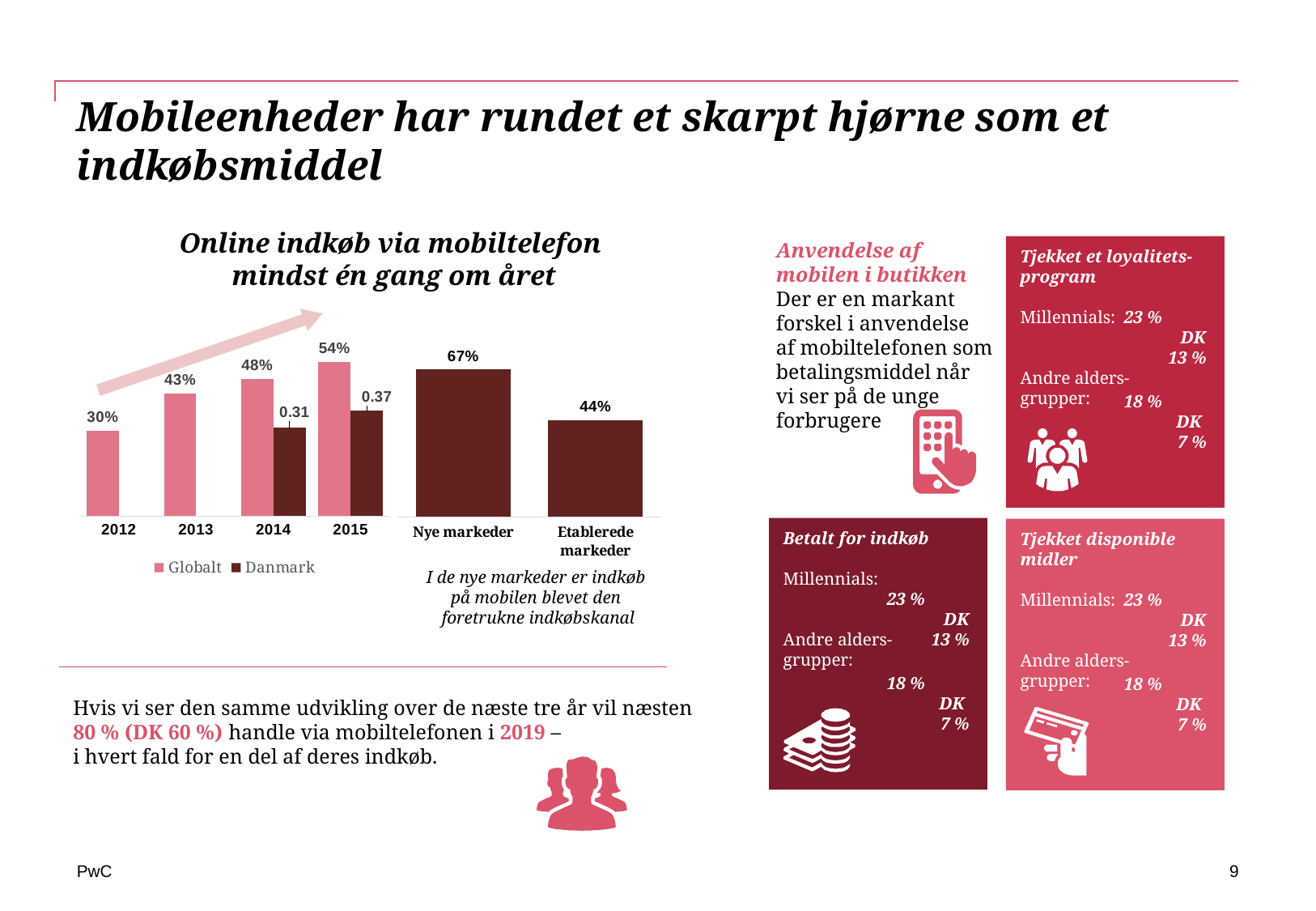
What is the Globalt value for 2012 in the chart 'Online indkøb via mobiltelefon mindst én gang om året'? 30% What is the difference between the Globalt values for 2015 and 2012? 24% Does the Globalt series rise or fall from 2012 to 2015? rise What value is shown for 'Nye markeder' in the chart? 67% Which is larger, the value for 'Nye markeder' or 'Etablerede markeder'? Nye markeder What is the Danmark value for 2014 in the chart? 0.31 Which year has the lowest Globalt value in the chart? 2012 What value is shown for 'Etablerede markeder' in the chart? 44% What is the Globalt value for 2015 in the chart? 54% What is the Danmark value for 2015 in the chart? 0.37 Which year has the highest Globalt value in the chart? 2015 How many series does the chart legend list? 2